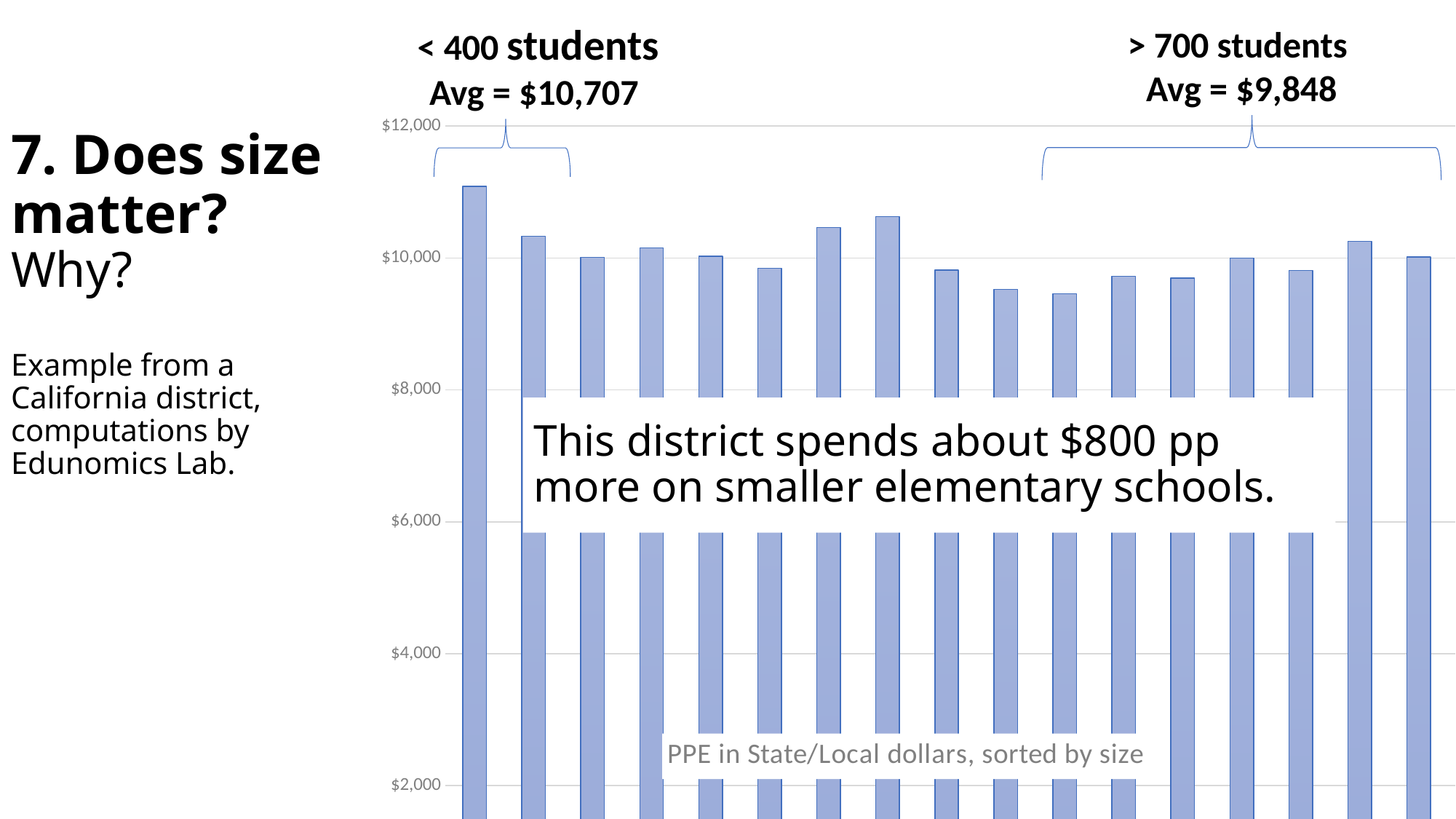
Are all bars in the chart greater than $8,000? yes Which is larger, the leftmost bar or the rightmost bar? the leftmost bar What kind of chart is shown on the slide? bar chart What is the caption describing the data in the chart? PPE in State/Local dollars, sorted by size Is the value of the second bar from the left greater or less than $10,000? greater What is the average PPE shown for schools with fewer than 400 students? $10,707 Are any bars in the chart greater than $12,000? no Which bar has the highest value in the chart? the leftmost bar How many bars are plotted in the chart? 17 What is the average PPE shown for schools with more than 700 students? $9,848